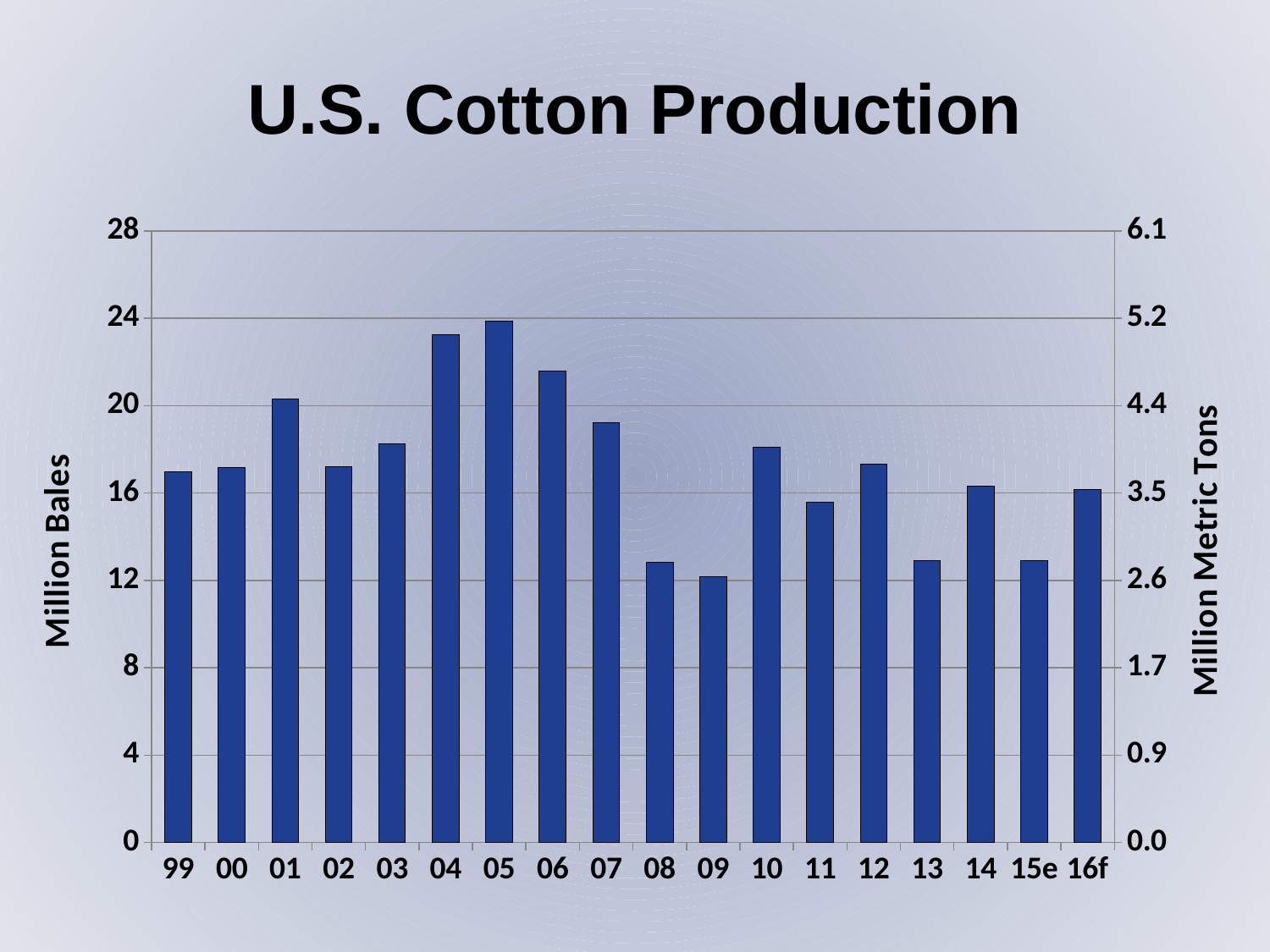
Which year has the highest cotton production? 05 Is the value for 04 greater or less than 20 million bales? greater How many years (bars) are shown on the x axis? 18 Do the values rise or fall from 05 to 09? fall Is the value for 08 greater or less than 16 million bales? less What is the label on the left vertical axis? Million Bales Which year has the larger production, 05 or 06? 05 What is the title of the chart? U.S. Cotton Production Is the value for 09 greater or less than 16 million bales? less Which year has the lowest cotton production? 09 What kind of chart is shown on the slide? bar chart